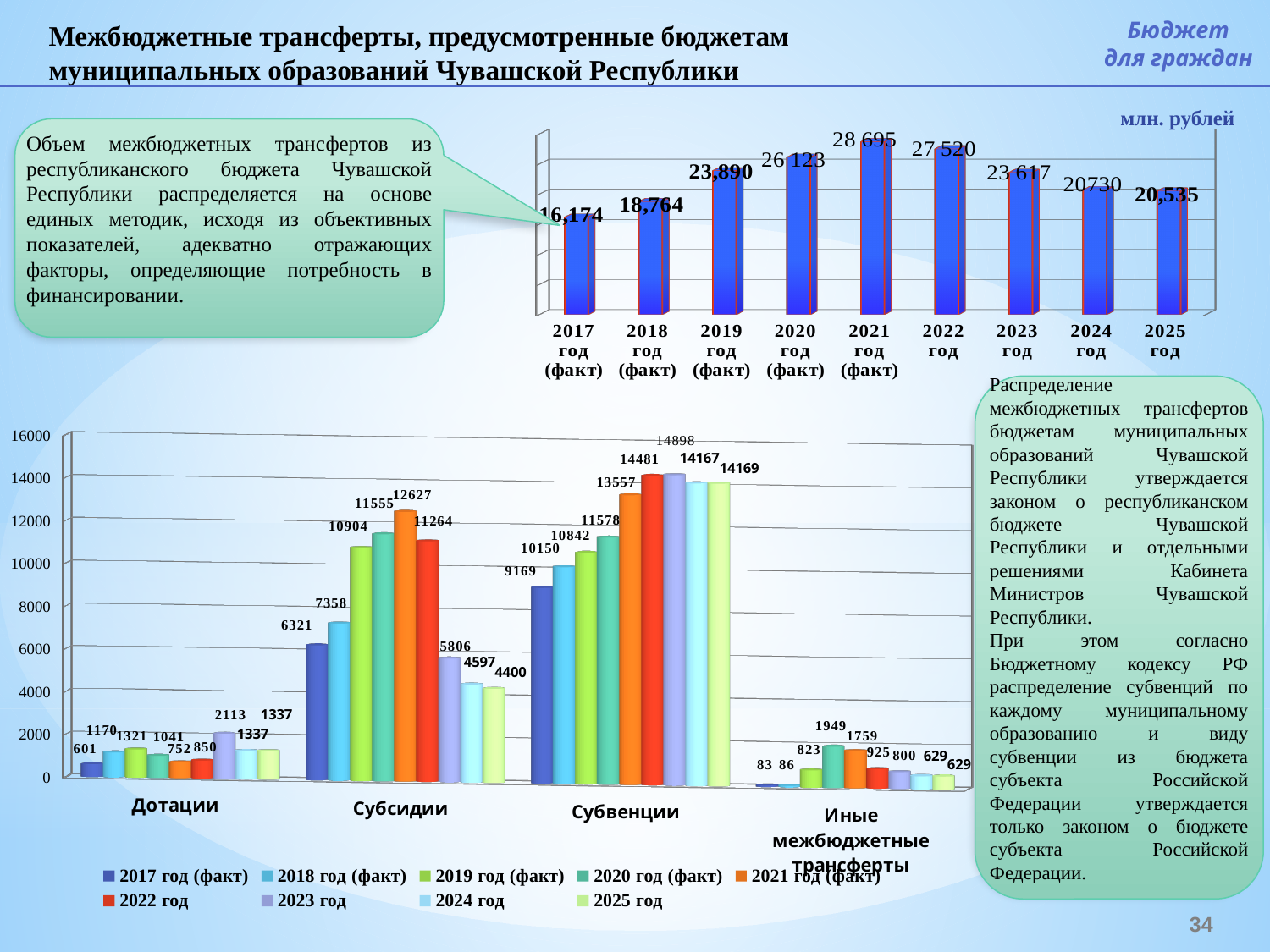
In the bottom chart, how many series does the legend list? 9 In the bottom chart, what is the difference between the 2022 год and 2017 год (факт) values for Субвенции? 5312 In the top chart, what unit is indicated above the chart? млн. рублей In the bottom chart, which is larger for Дотации: 2023 год or 2025 год? 2023 год In the bottom chart, what is the value for Субвенции in 2023 год? 14898 In the top chart, what is the value for 2017 год (факт)? 16,174 What kind of chart is the bottom chart? Bar chart In the top chart, which year has the highest value? 2021 год (факт) In the bottom chart, what is the value for Субсидии in 2021 год (факт)? 12627 In the top chart, what is the value for 2021 год (факт)? 28 695 In the top chart, which year has the lowest value? 2017 год (факт) In the top chart, how many years are shown on the x axis? 9